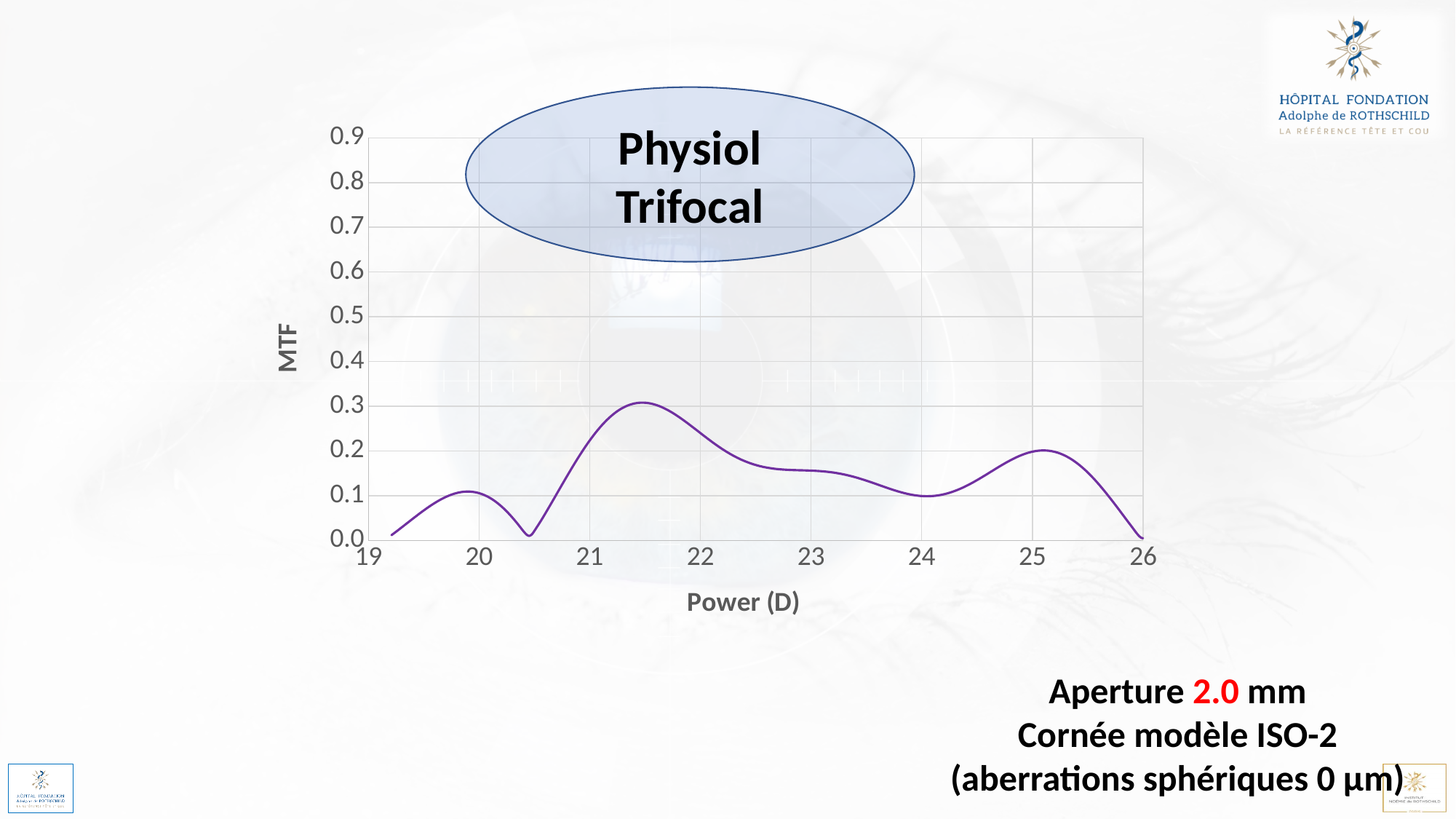
How many lines (series) are plotted on the chart? 1 Is the MTF value at a power of 20 D greater or less than 0.2? less Does the MTF curve rise or fall between 25 D and 26 D? fall What is the highest tick value shown on the y axis of the chart? 0.9 Does the MTF curve rise or fall between 24 D and 25 D? rise Is the MTF value at a power of 25 D greater or less than 0.3? less Is the highest peak of the MTF curve located between 21 and 22 D or between 25 and 26 D? between 21 and 22 D What is the label of the x axis of the chart? Power (D) Is the MTF value at a power of 23 D greater or less than 0.1? greater What is the label of the y axis of the chart? MTF What kind of chart is shown on the slide? line chart